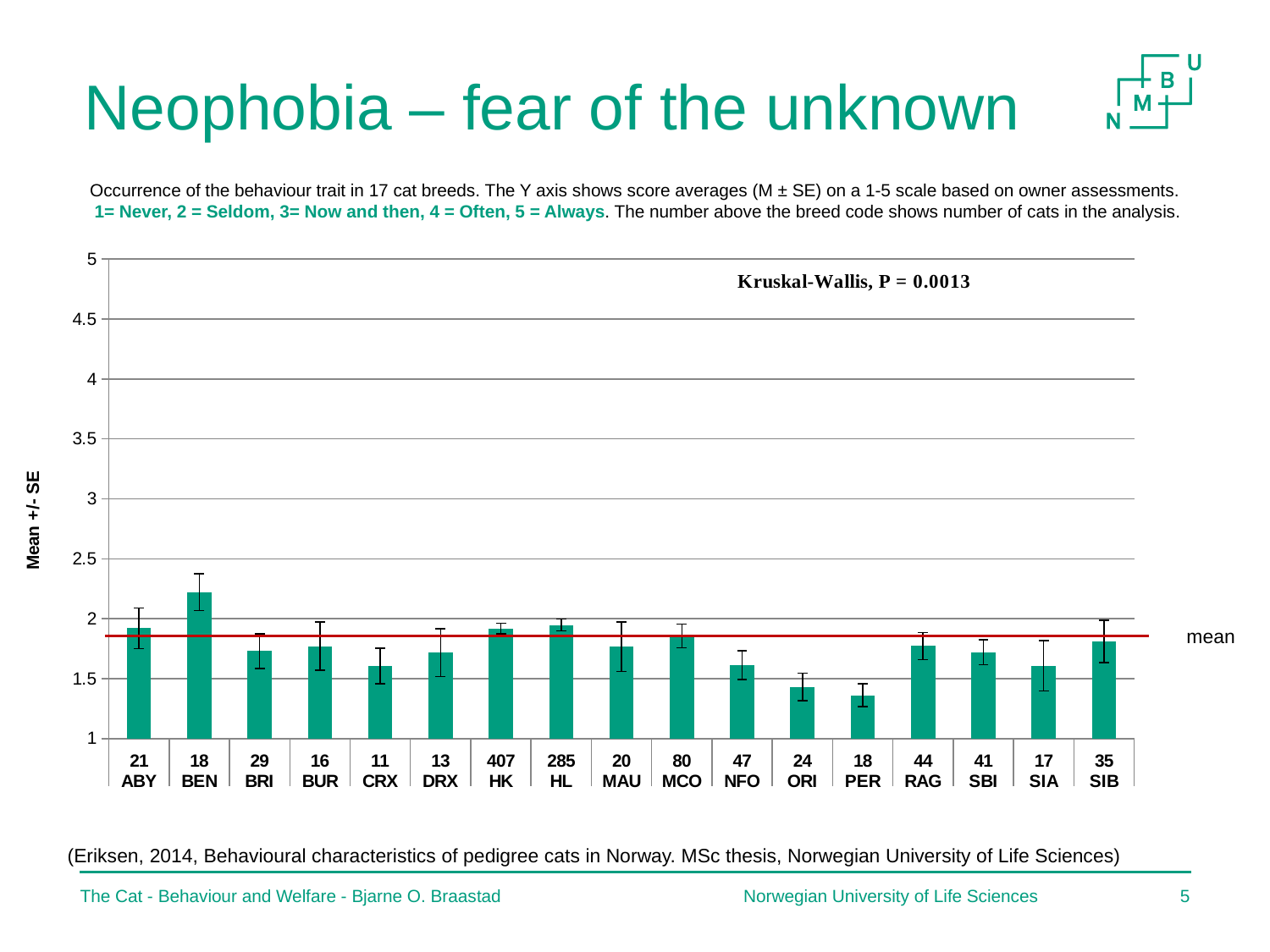
What does the red horizontal line across the chart represent? mean Which breed has the highest mean neophobia score? BEN Which breed has the lowest mean neophobia score? PER How many cats were in the analysis for the HK breed? 407 Which has the larger mean score, RAG or ORI? RAG Is the value for MCO greater or less than 2? less What is the Kruskal-Wallis P value shown on the chart? P = 0.0013 How many cat breeds are plotted on the x axis? 17 Is the value for BEN greater or less than 2? greater Is the value for ORI greater or less than 1.5? less What kind of chart is shown on the slide? bar chart